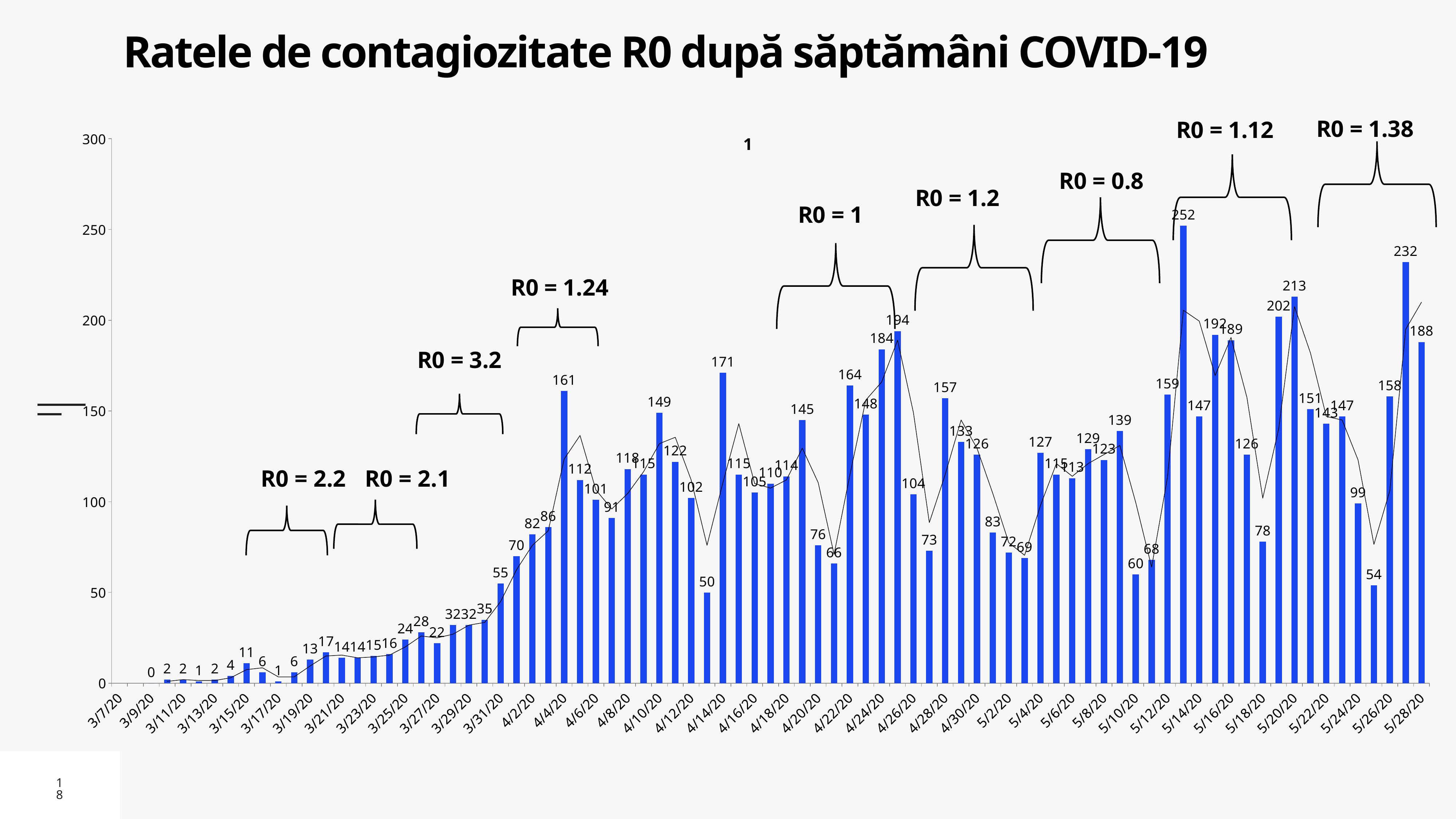
What is the highest R0 value annotated above the chart? R0 = 3.2 Do the bar values generally rise or fall from March to May along the x axis? rise What kind of chart is shown on the slide? bar chart What is the value of the last bar, for 5/28/20? 188 What is the title of the chart? Ratele de contagiozitate R0 după săptămâni COVID-19 Which is larger, the bar labeled 213 or the bar labeled 232? 232 Is the value for 5/28/20 greater or less than 150? greater Which is larger, the bar labeled 171 or the bar labeled 161? 171 What is the lowest value labeled on any bar in the chart? 0 What is the highest value labeled on any bar in the chart? 252 What is the difference between the two tallest bars, labeled 252 and 232? 20 What is the difference between the bars labeled 202 and 213? 11